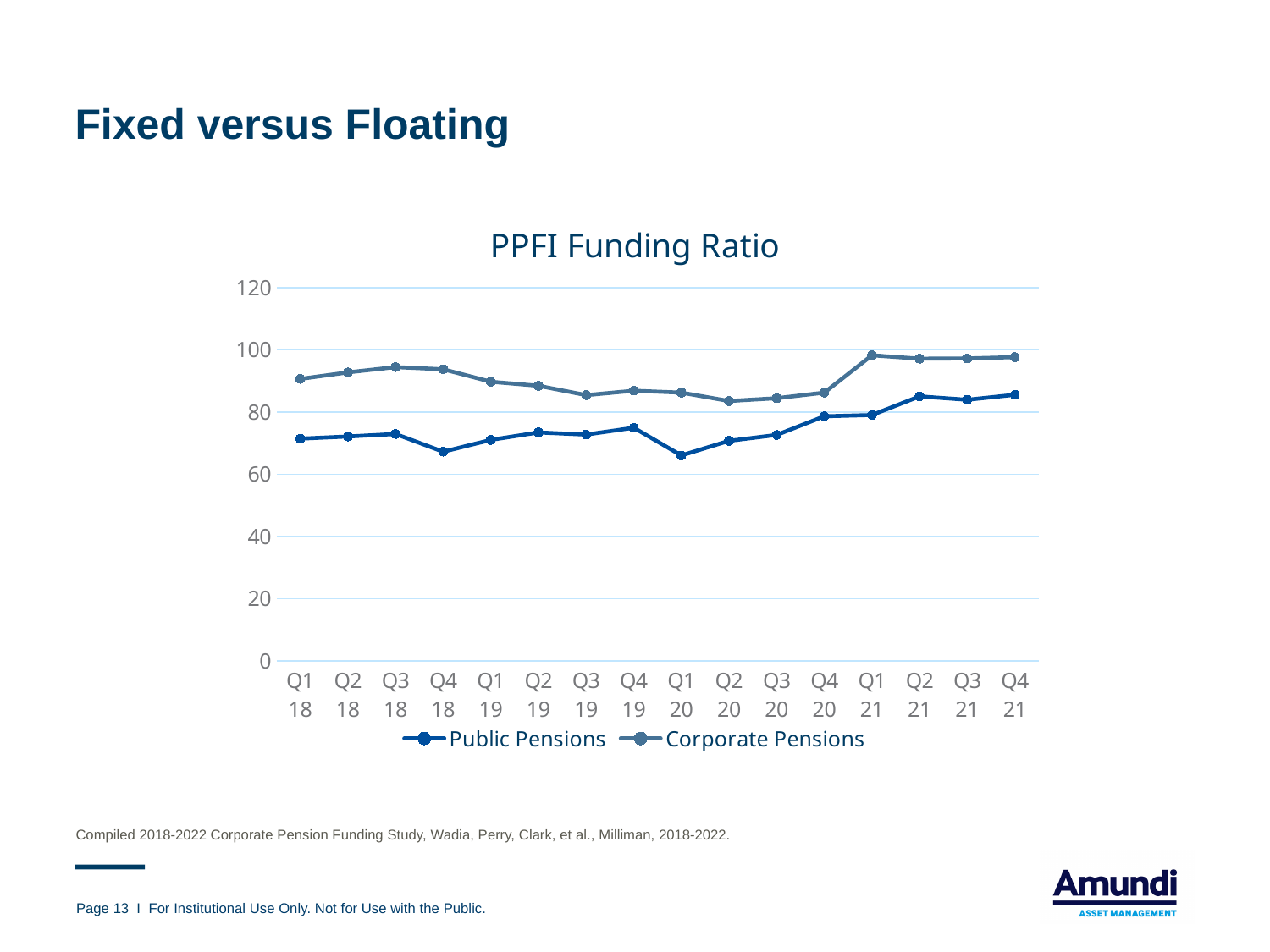
For Public Pensions, which is larger: the value at Q1 20 or the value at Q2 21? Q2 21 Is the Corporate Pensions value for Q3 18 greater or less than 100? less Is the Corporate Pensions value for Q1 21 greater or less than 80? greater What is the title of the chart? PPFI Funding Ratio Is the Public Pensions value for Q1 20 greater or less than 80? less At Q1 18, which series has the higher value, Public Pensions or Corporate Pensions? Corporate Pensions How many quarterly points are plotted along the x axis of the PPFI Funding Ratio chart? 16 Does the Corporate Pensions line rise or fall between Q3 18 and Q2 20? Fall What kind of chart is shown on the slide? Line chart How many series does the legend of the PPFI Funding Ratio chart list? 2 Which two series are listed in the chart legend? Public Pensions and Corporate Pensions